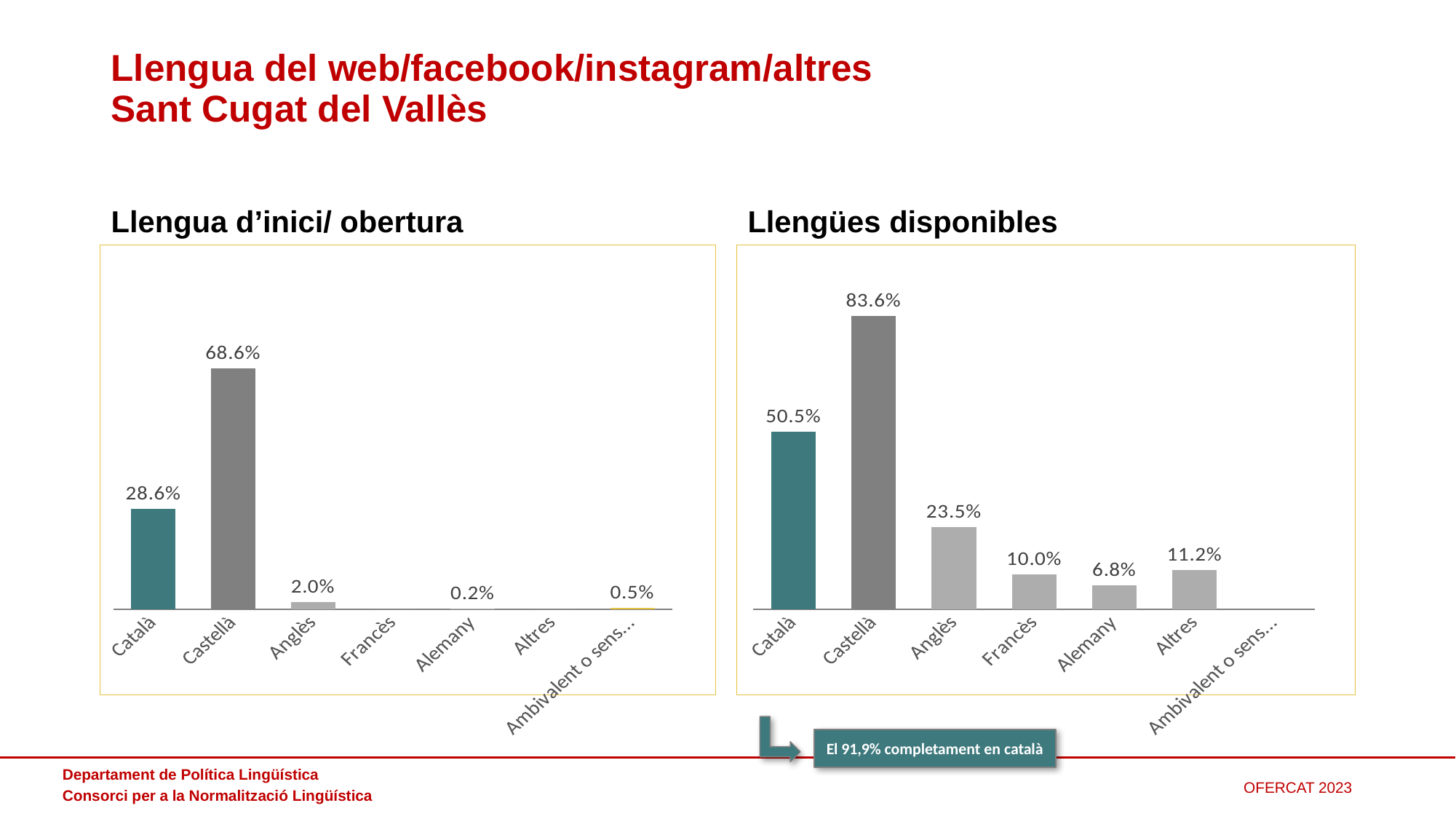
In the 'Llengües disponibles' chart, which is larger, Francès or Altres? Altres What kind of chart is the 'Llengua d'inici/ obertura' chart? Bar chart In the 'Llengües disponibles' chart, what is the value for Alemany? 6.8% In the 'Llengua d'inici/ obertura' chart, what is the value for Anglès? 2.0% How many categories are shown on the x axis of the 'Llengües disponibles' chart? 7 In the 'Llengua d'inici/ obertura' chart, what is the difference between Castellà and Català? 40.0% In the 'Llengües disponibles' chart, what is the difference between Castellà and Català? 33.1% In the 'Llengües disponibles' chart, what is the value for Anglès? 23.5% In the 'Llengua d'inici/ obertura' chart, what is the value for Català? 28.6% In the 'Llengua d'inici/ obertura' chart, which category has the highest value? Castellà In the 'Llengües disponibles' chart, what is the value for Castellà? 83.6% In the 'Llengua d'inici/ obertura' chart, what is the value for Castellà? 68.6%